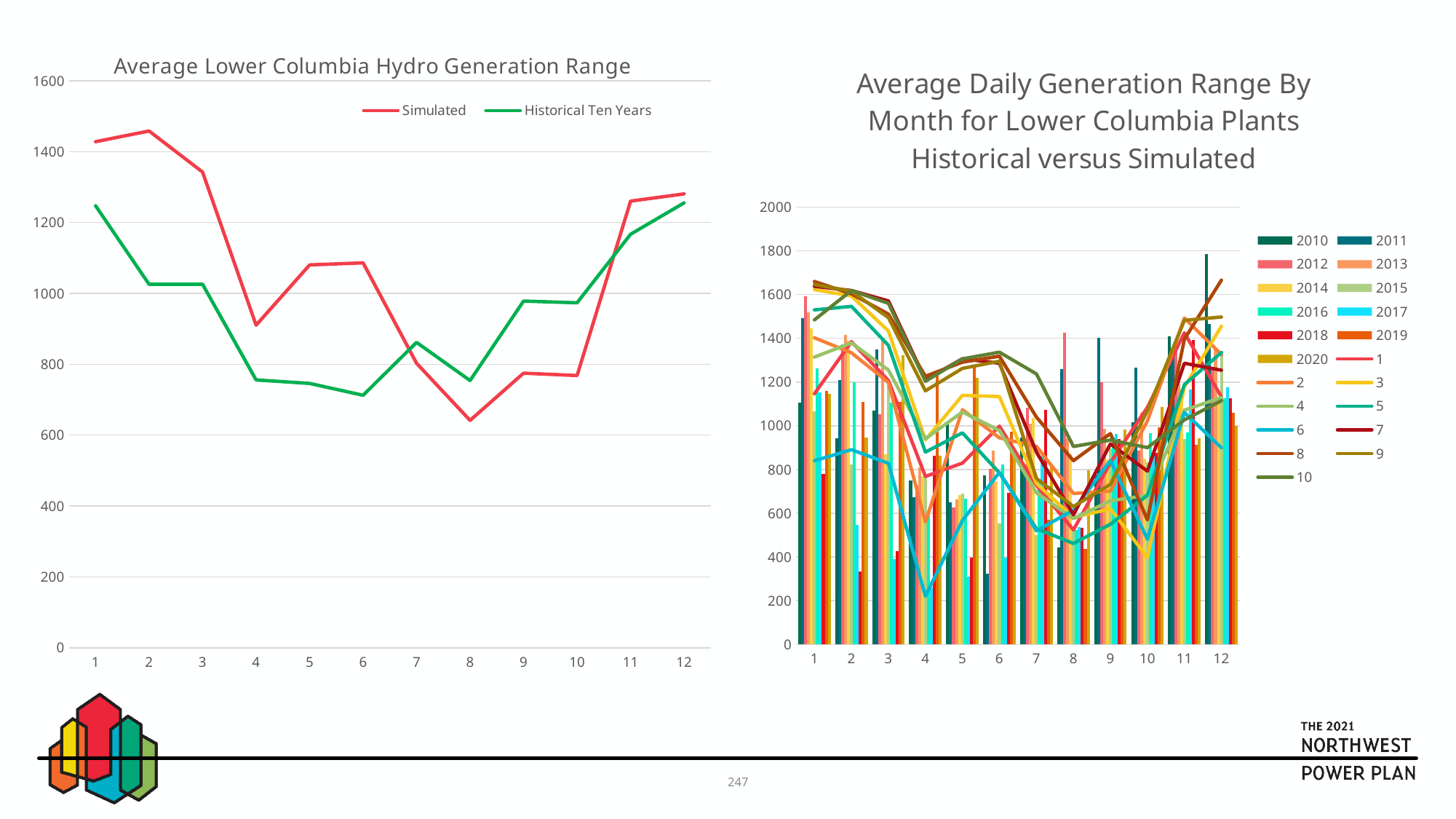
On the left chart, Average Lower Columbia Hydro Generation Range, does the Simulated series rise or fall from month 8 to month 12? Rise On the left chart, Average Lower Columbia Hydro Generation Range, is the Historical Ten Years value at month 6 greater or less than 800? less On the right chart, Average Daily Generation Range By Month for Lower Columbia Plants Historical versus Simulated, in which month does the tallest bar appear? 12 On the left chart, Average Lower Columbia Hydro Generation Range, at month 10, which series is larger, Simulated or Historical Ten Years? Historical Ten Years On the left chart, Average Lower Columbia Hydro Generation Range, how many series does the legend list? 2 On the left chart, Average Lower Columbia Hydro Generation Range, how many points are plotted along the x axis for each series? 12 On the left chart, Average Lower Columbia Hydro Generation Range, at which month is the Simulated series highest? 2 On the right chart, Average Daily Generation Range By Month for Lower Columbia Plants Historical versus Simulated, how many entries does the legend list? 21 On the left chart, Average Lower Columbia Hydro Generation Range, at which month is the Simulated series lowest? 8 On the left chart, Average Lower Columbia Hydro Generation Range, is the Simulated value at month 8 greater or less than 800? less On the left chart, Average Lower Columbia Hydro Generation Range, at month 1, which series is larger, Simulated or Historical Ten Years? Simulated On the left chart, Average Lower Columbia Hydro Generation Range, what kind of chart is it? Line chart